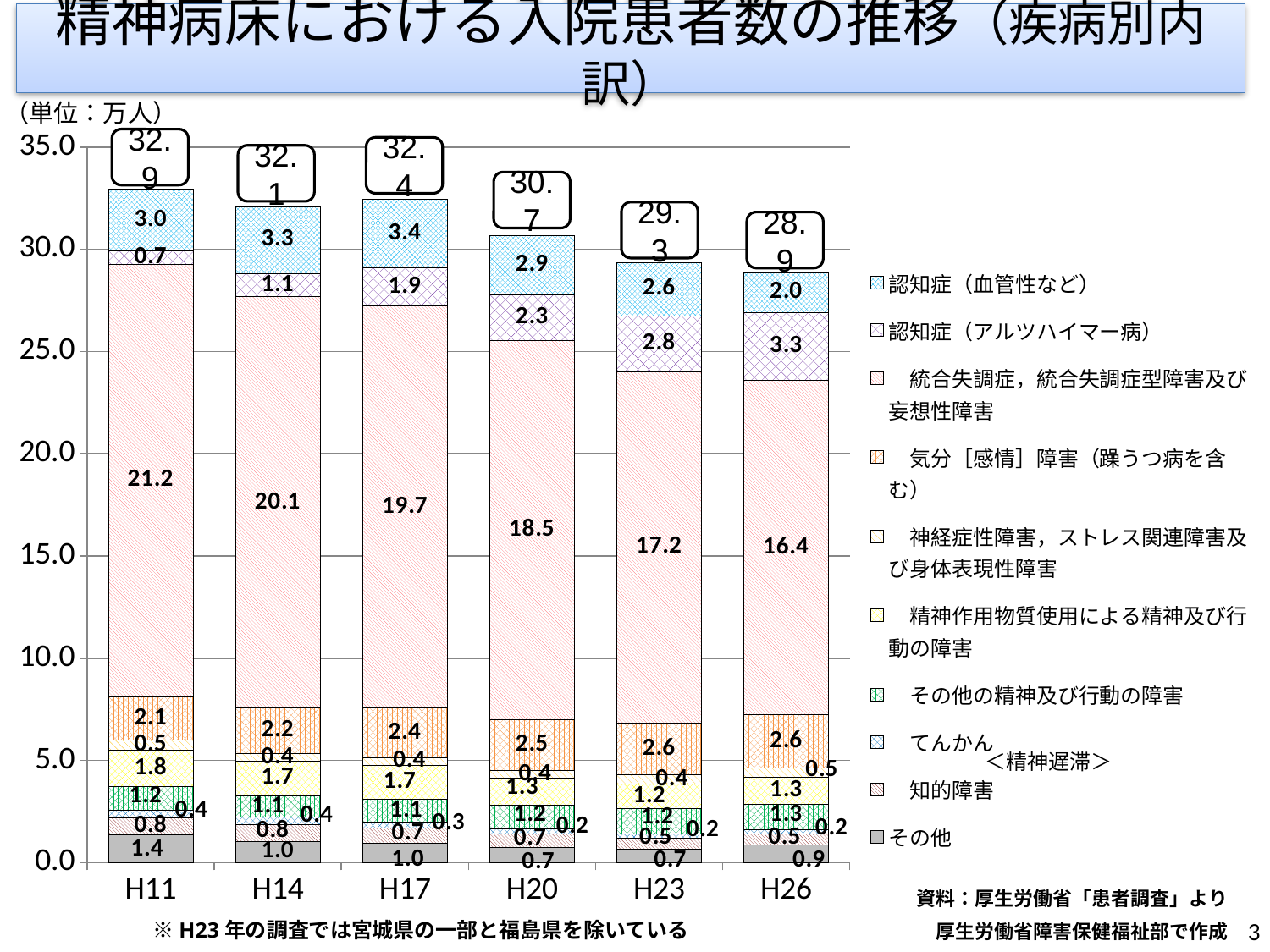
By how much did the 統合失調症 segment decrease from H11 to H26? 4.8 What is the value of the 認知症（アルツハイマー病） segment for H23? 2.8 How many years (bars) are shown on the x axis? 6 What kind of chart is shown on the slide? Stacked bar chart Which year has the lowest total number of inpatients? H26 Which is larger, the 認知症（血管性など） segment in H17 or in H26? H17 What is the total number of inpatients shown above the H11 bar? 32.9 Which year has the highest total number of inpatients? H11 Does the 認知症（アルツハイマー病） segment rise or fall from H11 to H26? Rise What is the value of the 気分［感情］障害 segment for H17? 2.4 What is the value of the 統合失調症 segment for H26? 16.4 How many series does the legend list? 10